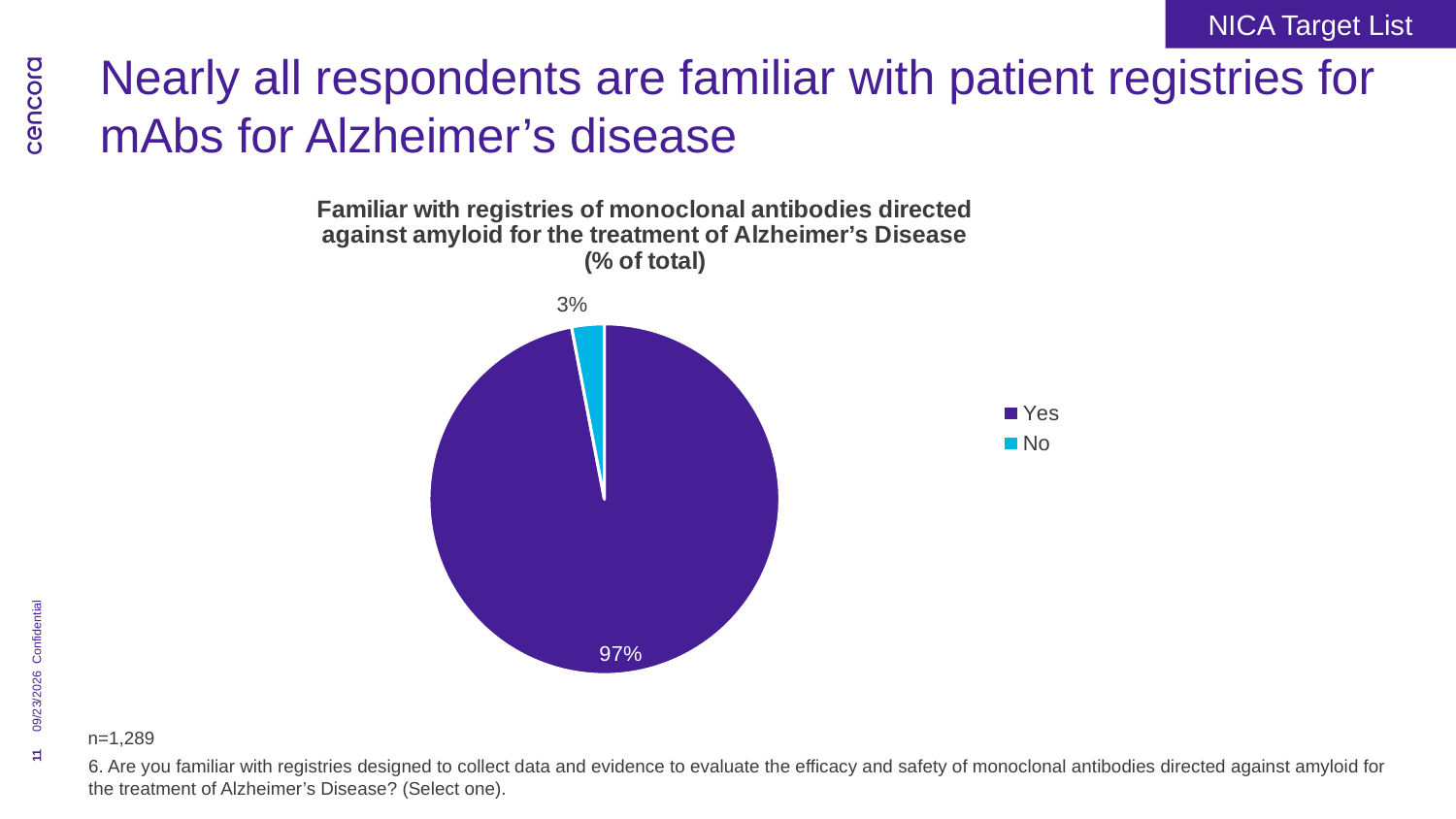
Which response has the largest share of the pie? Yes How many entries does the legend list? 2 How many slices does the pie chart have? 2 Which is larger, the share for Yes or the share for No? Yes What is the difference in percentage points between the Yes and No shares? 94 Which colour represents the No slice in the pie chart? Light blue What kind of chart is shown on the slide? Pie chart What share of the pie does the No slice represent? 3% What percentage of respondents answered Yes? 97% Which response has the smallest share of the pie? No What is the sample size (n) stated below the chart? n=1,289 What percentage of respondents answered No? 3%